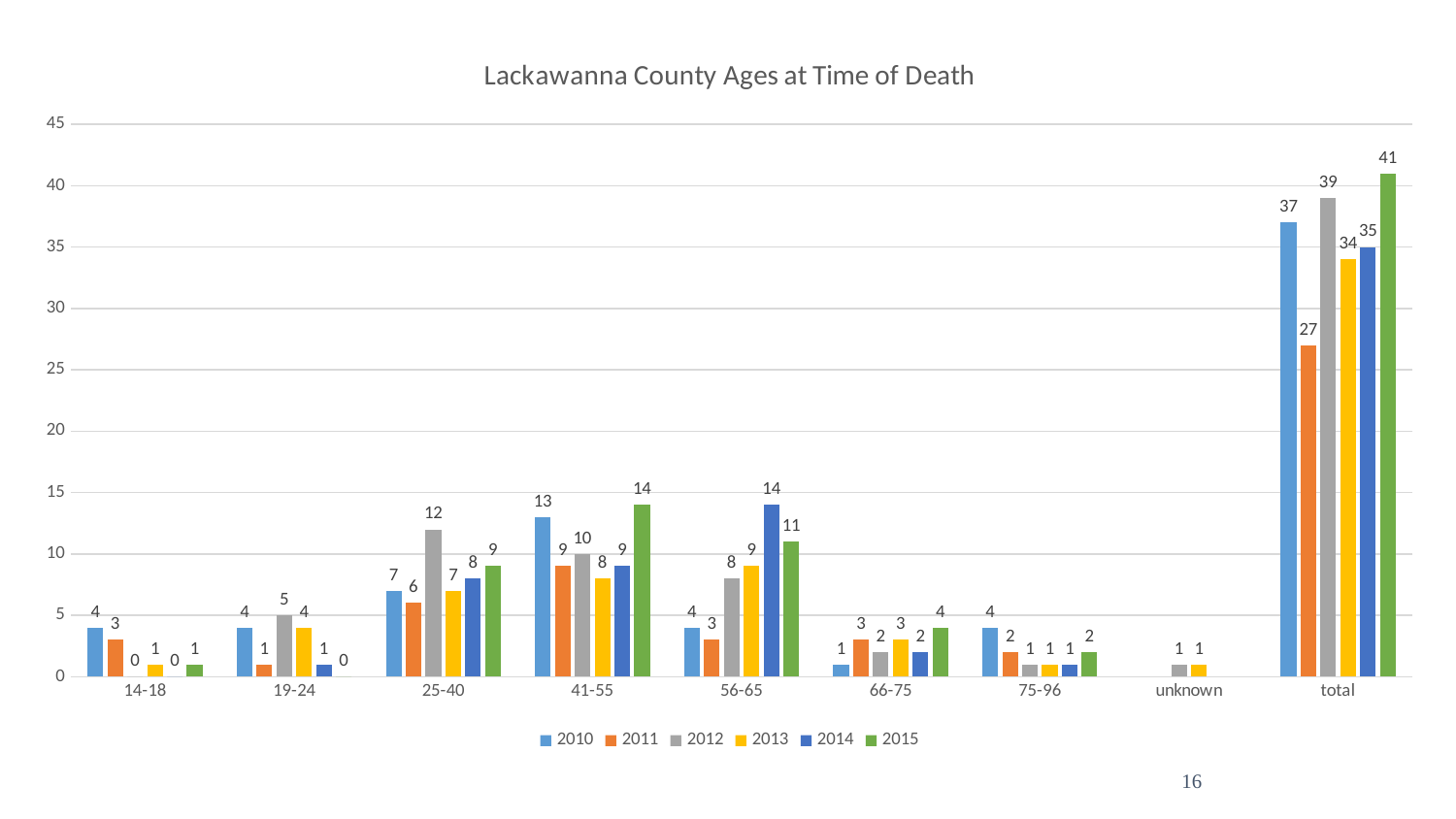
Which years have a value of 1 in the unknown category? 2012 and 2013 What is the value for 2014 in the 56-65 age group? 14 How many series does the legend list? 6 Which year has the lowest total? 2011 What is the total for 2015? 41 In the 41-55 age group, which is larger, the value for 2010 or the value for 2011? 2010 What is the difference between the 2015 total and the 2011 total? 14 What is the value for 2012 in the 25-40 age group? 12 How many age categories are shown on the x axis? 9 What is the title of the chart? Lackawanna County Ages at Time of Death What kind of chart is this? bar chart Which year has the highest total? 2015